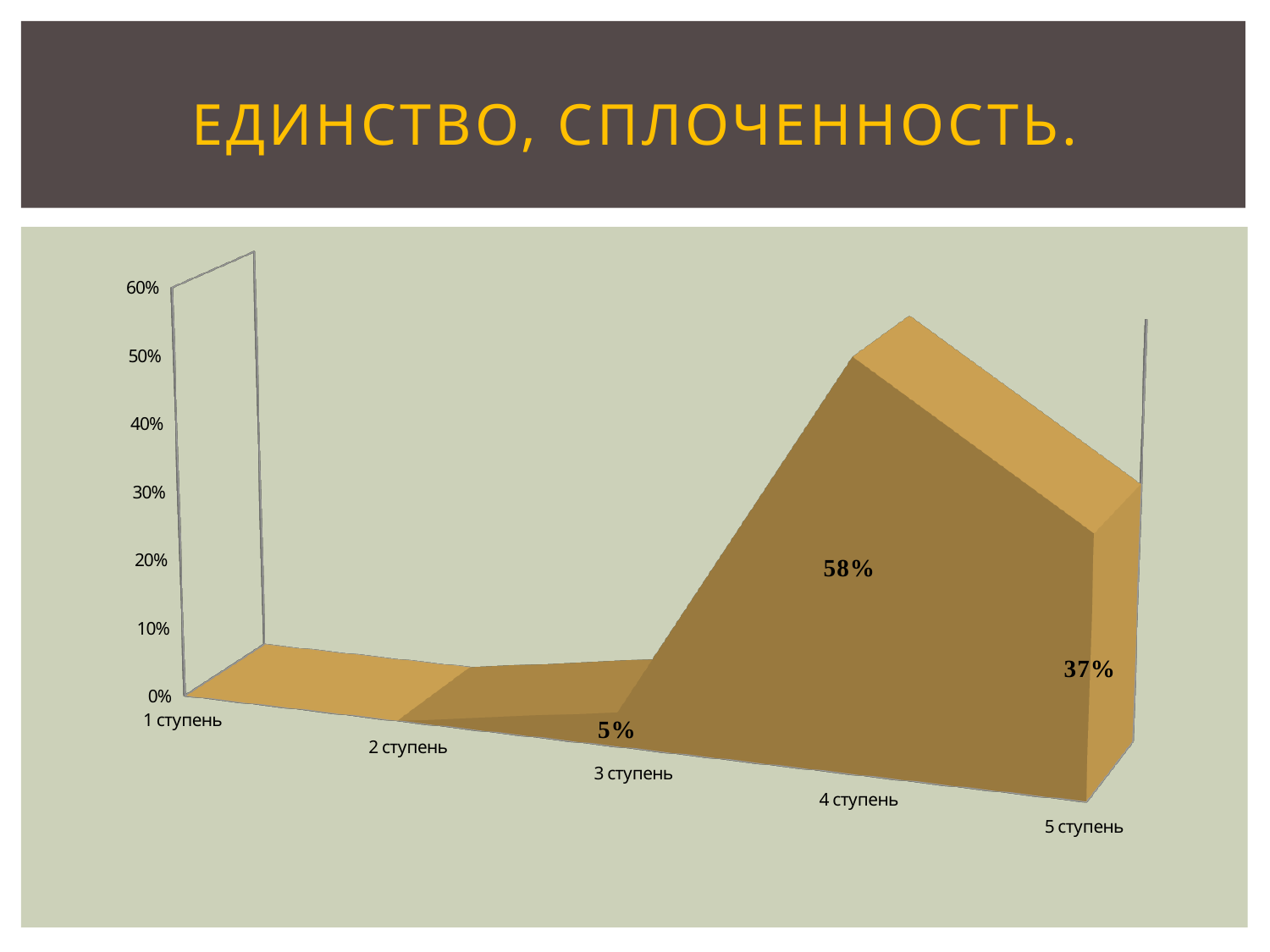
What is the difference between the values for 4 ступень and 3 ступень? 53% Is the value for 2 ступень greater or less than 10%? less What is the value for 3 ступень? 5% What kind of chart is shown on the slide? area chart What is the difference between the values for 4 ступень and 5 ступень? 21% Is the value for 4 ступень greater or less than 50%? greater Which category has the highest value? 4 ступень How many categories are shown on the x axis? 5 Does the value rise or fall from 4 ступень to 5 ступень? fall Which is larger, the value for 3 ступень or the value for 5 ступень? 5 ступень What is the value for 4 ступень? 58% What is the value for 5 ступень? 37%